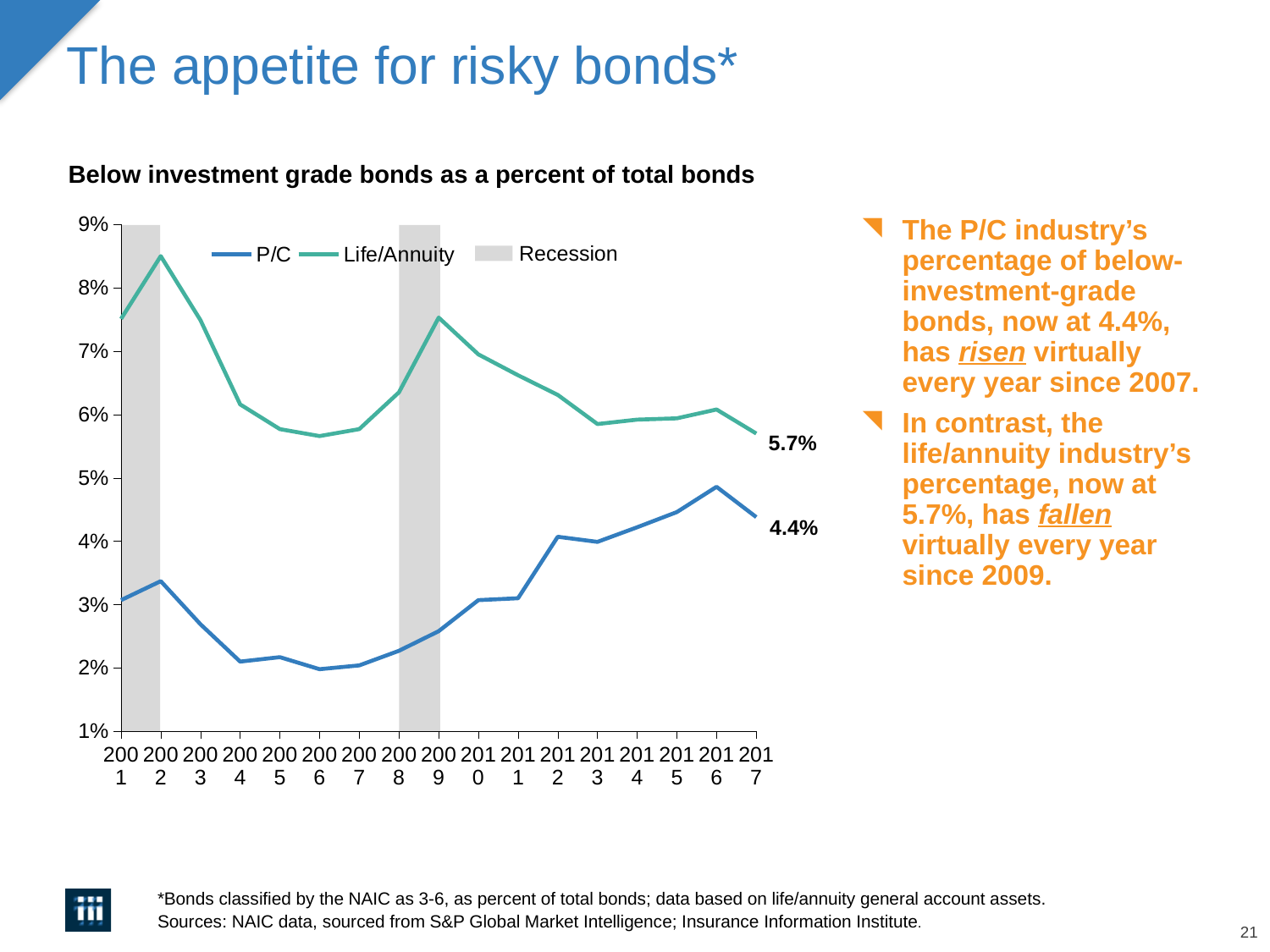
In which year does the Life/Annuity series reach its highest value? 2002 What is the Life/Annuity value for 2017? 5.7% What is the difference between the Life/Annuity and P/C values in 2017? 1.3% What is the P/C value for 2017? 4.4% Is the P/C value for 2016 greater or less than 5%? less Does the Life/Annuity series generally rise or fall from 2009 to 2017? fall How many entries does the legend list? 3 How many years are shown on the x axis? 17 In 2017, which series has the larger value, P/C or Life/Annuity? Life/Annuity Is the Life/Annuity value for 2002 greater or less than 8%? greater What kind of chart is shown? line chart In which year does the P/C series reach its highest value? 2016